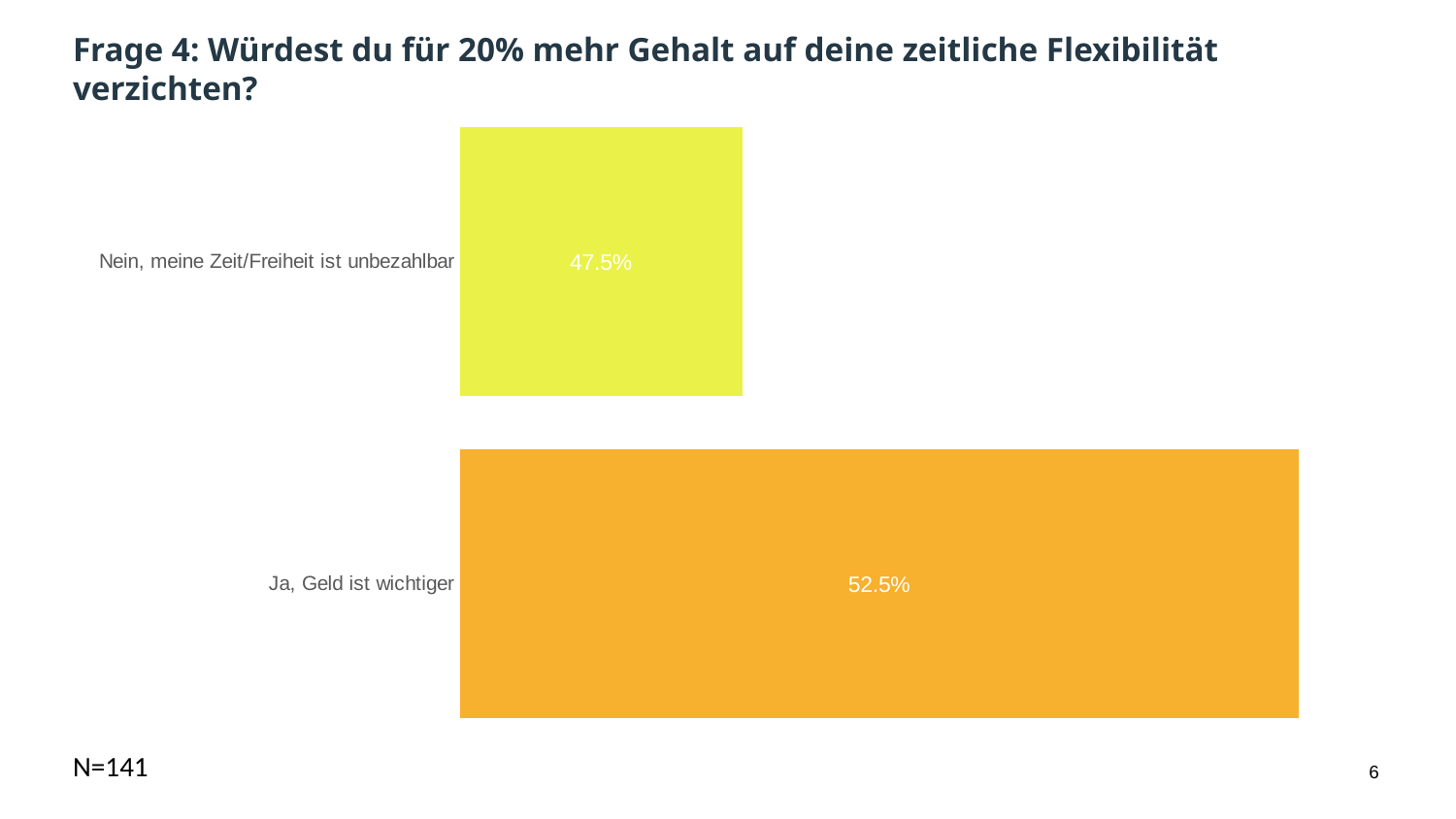
How many answer categories are shown in the chart? 2 What is the total of the two percentages shown in the chart? 100% What is the sample size (N) stated on the slide? N=141 What is the difference in percentage points between "Ja, Geld ist wichtiger" and "Nein, meine Zeit/Freiheit ist unbezahlbar"? 5 percentage points What type of chart is shown on the slide? bar chart Is the value for "Nein, meine Zeit/Freiheit ist unbezahlbar" larger or smaller than the value for "Ja, Geld ist wichtiger"? smaller What colour is the bar for "Ja, Geld ist wichtiger"? orange Which answer option has the higher share of respondents? Ja, Geld ist wichtiger What percentage of respondents answered "Nein, meine Zeit/Freiheit ist unbezahlbar"? 47.5% What percentage of respondents answered "Ja, Geld ist wichtiger"? 52.5% Which answer option has the lower share of respondents? Nein, meine Zeit/Freiheit ist unbezahlbar